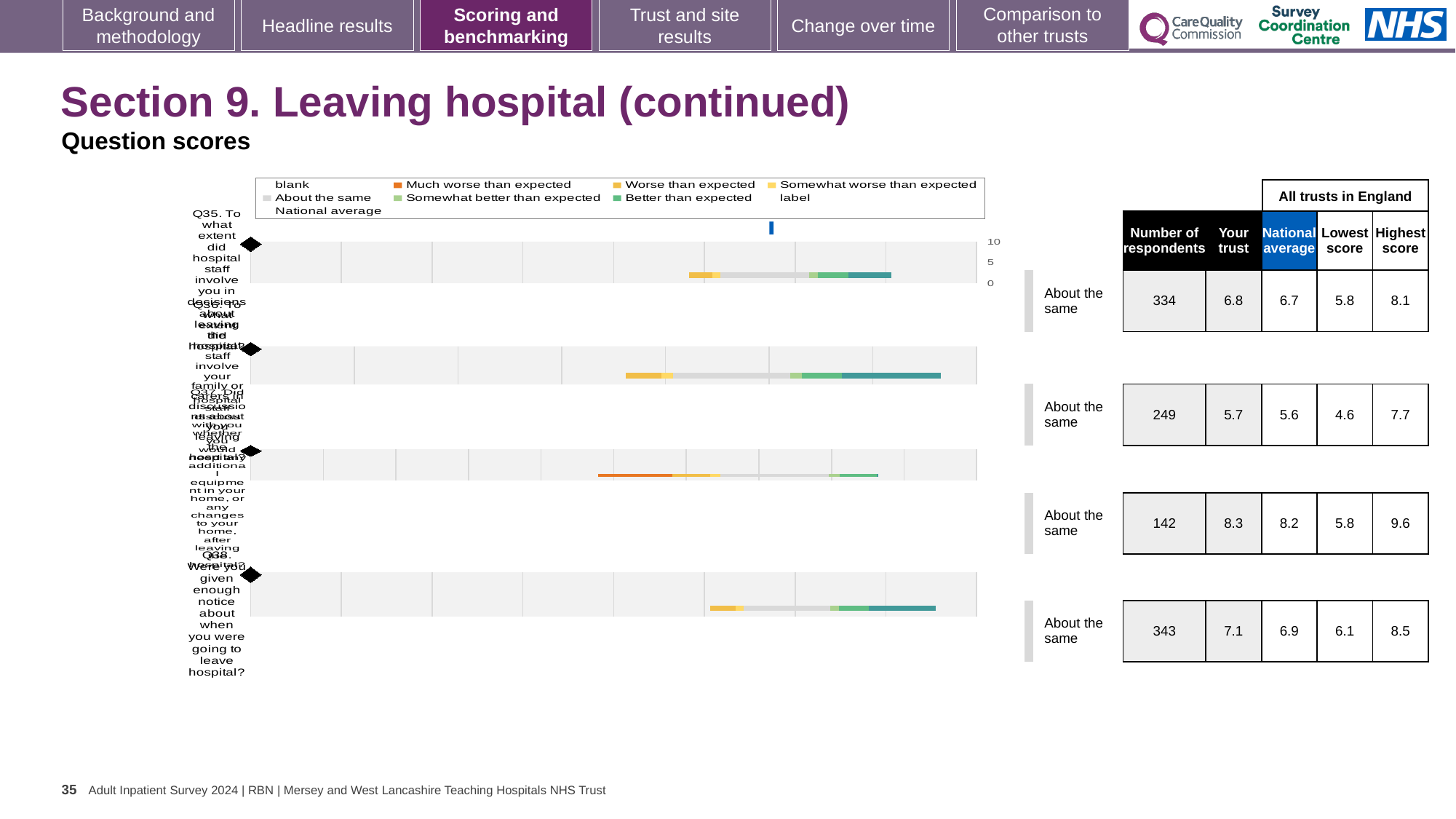
Which row in the table has the lowest number of respondents? Q37 (142) What benchmark category is shown for all four questions on the slide? About the same What is the subtitle of the chart section on the slide? Question scores For the second row (Q36), is the 'Your trust' score or the national average larger? Your trust (5.7) Which row in the table has the highest 'Your trust' score? Q37 (8.3) In the table beside the chart, what is the 'Your trust' score for the first row (Q35, involving you in decisions about leaving hospital)? 6.8 What kind of chart is shown on the slide? bar chart In the table beside the chart, how many respondents are listed for the last row (Q38, given enough notice about leaving hospital)? 343 How many question bars are plotted in the chart? 4 What is the difference between the highest score and the lowest score for the last row (Q38)? 2.4 In the table beside the chart, what is the national average for the third row (Q37)? 8.2